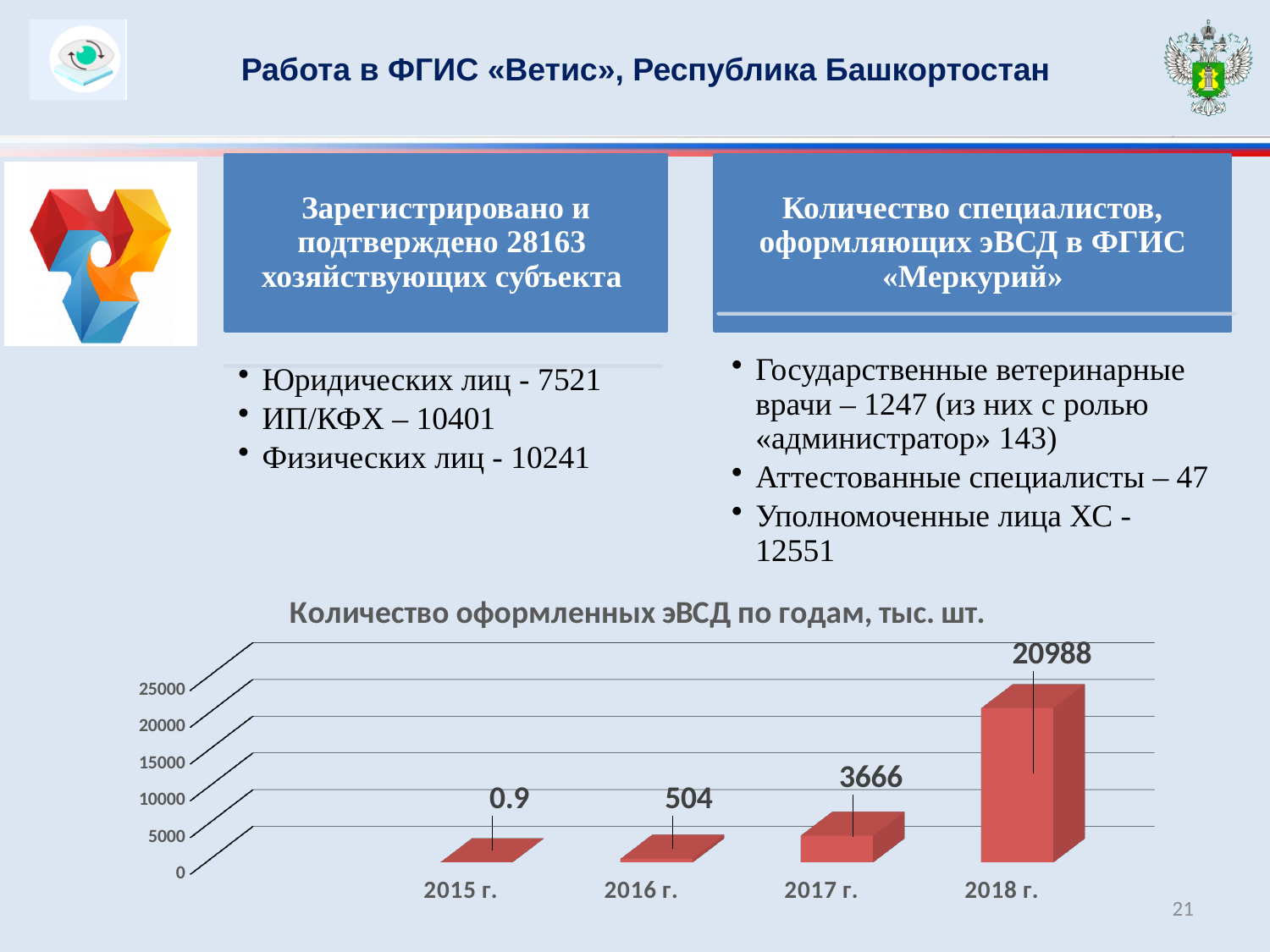
What is the difference between the values for 2018 г. and 2017 г.? 17322 Which year has the highest value in the chart? 2018 г. Which is larger, the value for 2016 г. or the value for 2017 г.? 2017 г. What is the difference between the values for 2017 г. and 2016 г.? 3162 What is the value for 2015 г. in the chart? 0.9 Which year has the lowest value in the chart? 2015 г. Is the value for 2018 г. greater or less than 20000? greater What is the value for 2016 г. in the chart? 504 What is the value for 2017 г. in the chart? 3666 What kind of chart is shown on the slide? bar chart How many years are shown on the x axis of the chart? 4 What is the value for 2018 г. in the chart 'Количество оформленных эВСД по годам, тыс. шт.'? 20988